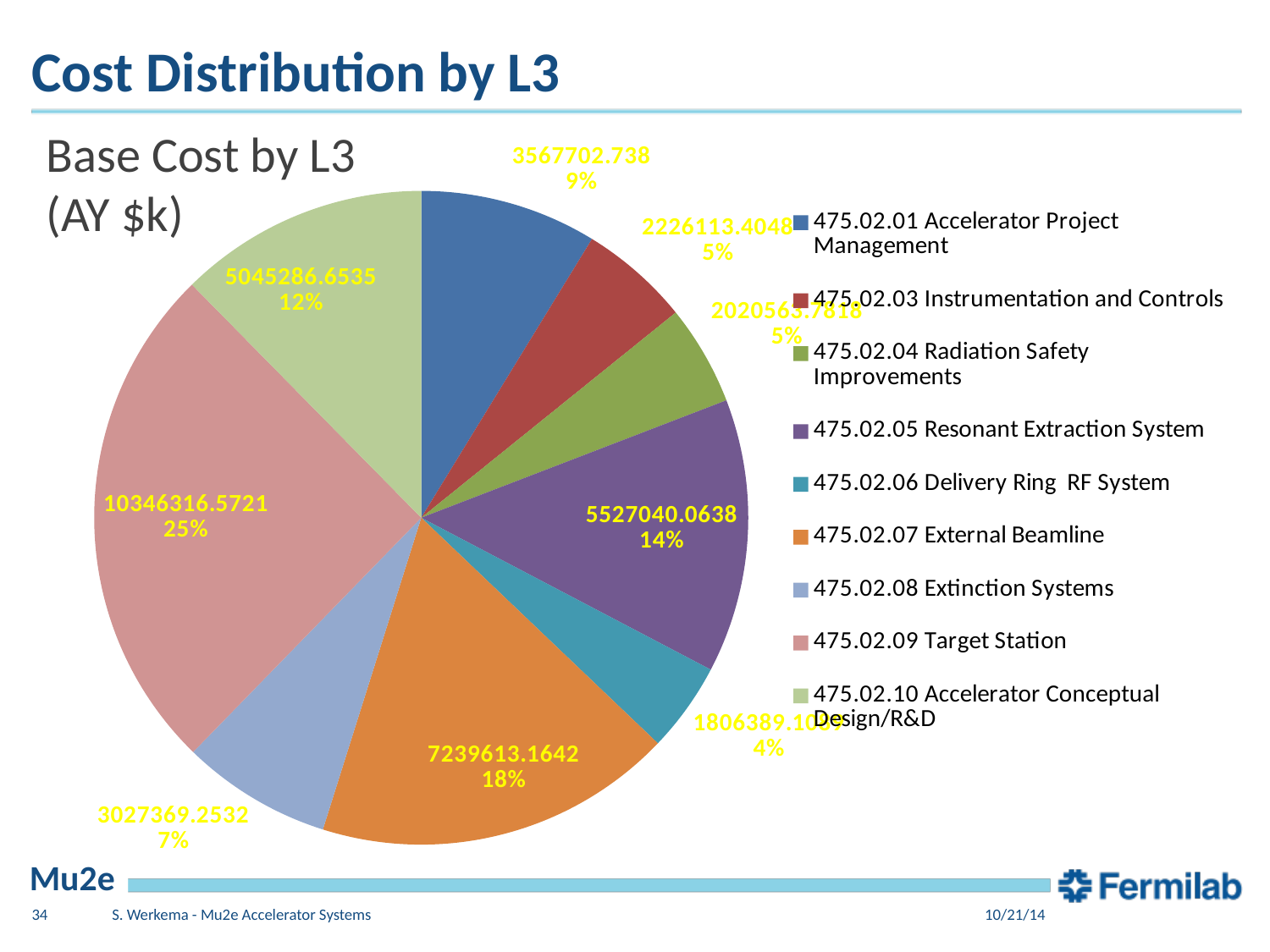
How many slices does the pie chart have? 9 What is the title of the pie chart? Base Cost by L3 (AY $k) Which is larger, the value for 475.02.01 Accelerator Project Management or the value for 475.02.08 Extinction Systems? 475.02.01 Accelerator Project Management What is the difference between the value for 475.02.07 External Beamline and the value for 475.02.05 Resonant Extraction System? 1712573.1004 What is the value shown for 475.02.07 External Beamline? 7239613.1642 Which category has the largest slice of the pie chart? 475.02.09 Target Station What kind of chart is shown on the slide? pie chart How many entries does the legend of the pie chart list? 9 What percentage share of the pie does 475.02.10 Accelerator Conceptual Design/R&D have? 12% Which category has the smallest slice of the pie chart? 475.02.06 Delivery Ring RF System What percentage share of the pie does 475.02.05 Resonant Extraction System have? 14% What is the value shown for 475.02.09 Target Station? 10346316.5721